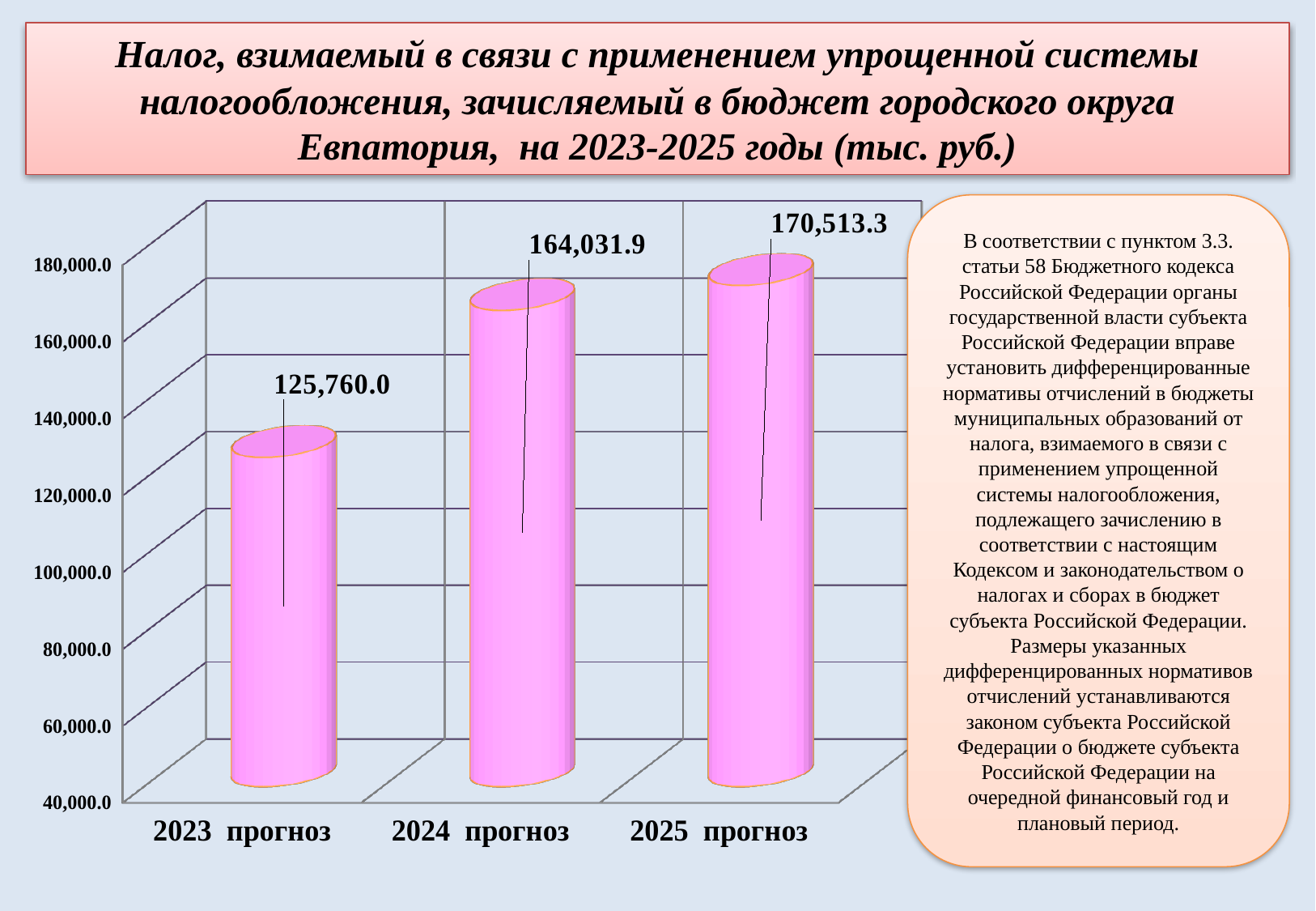
What is the value for 2023 прогноз? 125,760.0 What is the value for 2025 прогноз? 170,513.3 Is the value for 2023 прогноз greater or less than 140,000.0? less Which is larger, the value for 2023 прогноз or the value for 2024 прогноз? 2024 прогноз What kind of chart is shown on the slide? bar chart What is the difference between the values for 2024 прогноз and 2023 прогноз? 38,271.9 How many categories are shown on the chart? 3 Which year has the lowest value? 2023 прогноз What is the difference between the values for 2025 прогноз and 2024 прогноз? 6,481.4 Which year has the highest value? 2025 прогноз Do the values rise or fall from 2023 to 2025? rise What is the value for 2024 прогноз? 164,031.9